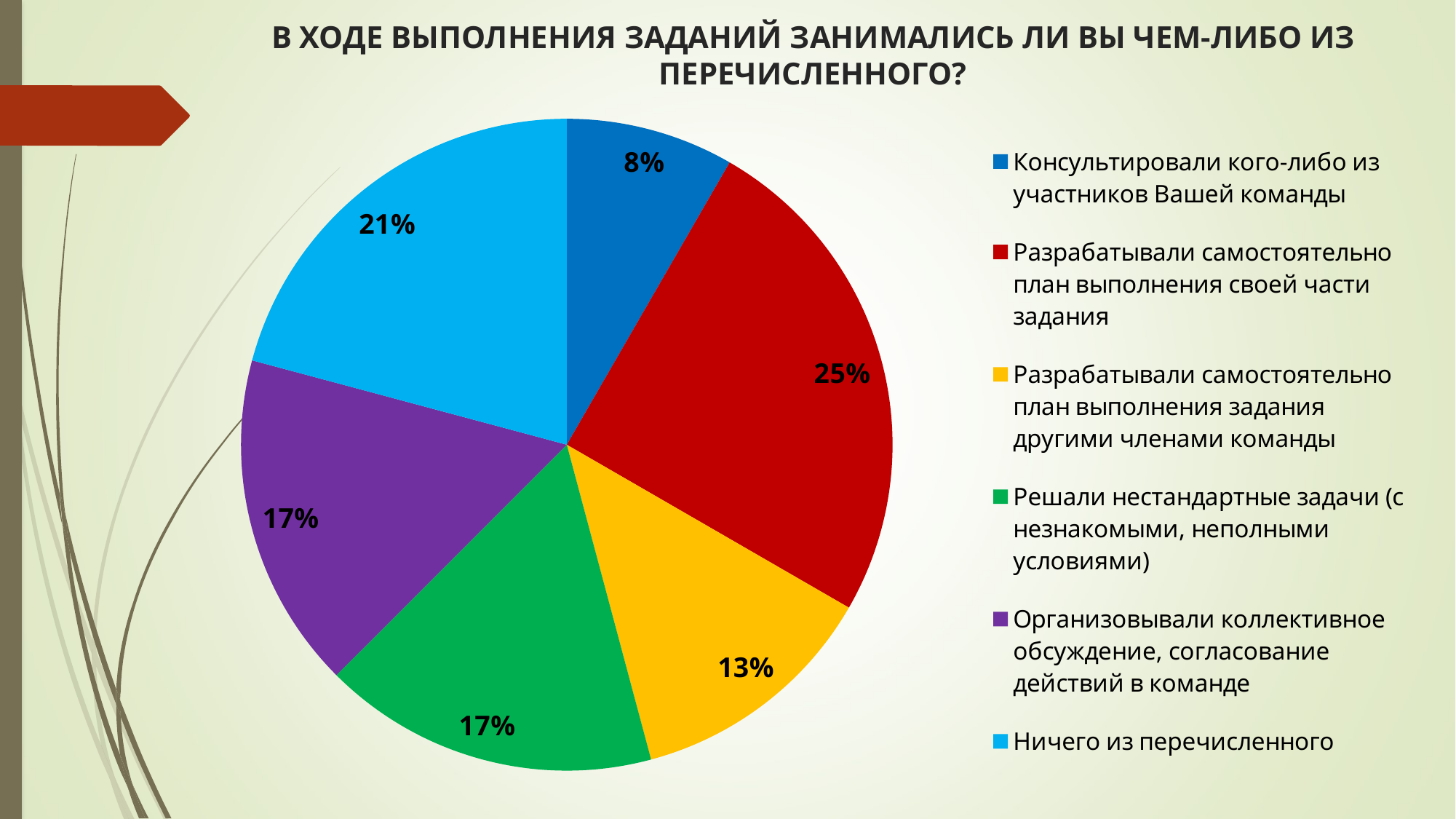
What colour is the slice for "Разрабатывали самостоятельно план выполнения своей части задания"? Red Which category has the largest slice of the pie? Разрабатывали самостоятельно план выполнения своей части задания What type of chart is shown on the slide? Pie chart Which is larger: the slice for "Ничего из перечисленного" or the slice for "Организовывали коллективное обсуждение, согласование действий в команде"? Ничего из перечисленного What is the title of the chart? В ХОДЕ ВЫПОЛНЕНИЯ ЗАДАНИЙ ЗАНИМАЛИСЬ ЛИ ВЫ ЧЕМ-ЛИБО ИЗ ПЕРЕЧИСЛЕННОГО? What share of the pie is labelled for "Ничего из перечисленного"? 21% How many categories does the pie chart have? 6 What percentage is shown for "Решали нестандартные задачи (с незнакомыми, неполными условиями)"? 17% What percentage is shown for "Разрабатывали самостоятельно план выполнения задания другими членами команды"? 13% What is the difference in percentage points between the largest slice (25%) and the smallest slice (8%)? 17 Which category has the smallest slice of the pie? Консультировали кого-либо из участников Вашей команды What percentage is shown for "Консультировали кого-либо из участников Вашей команды"? 8%